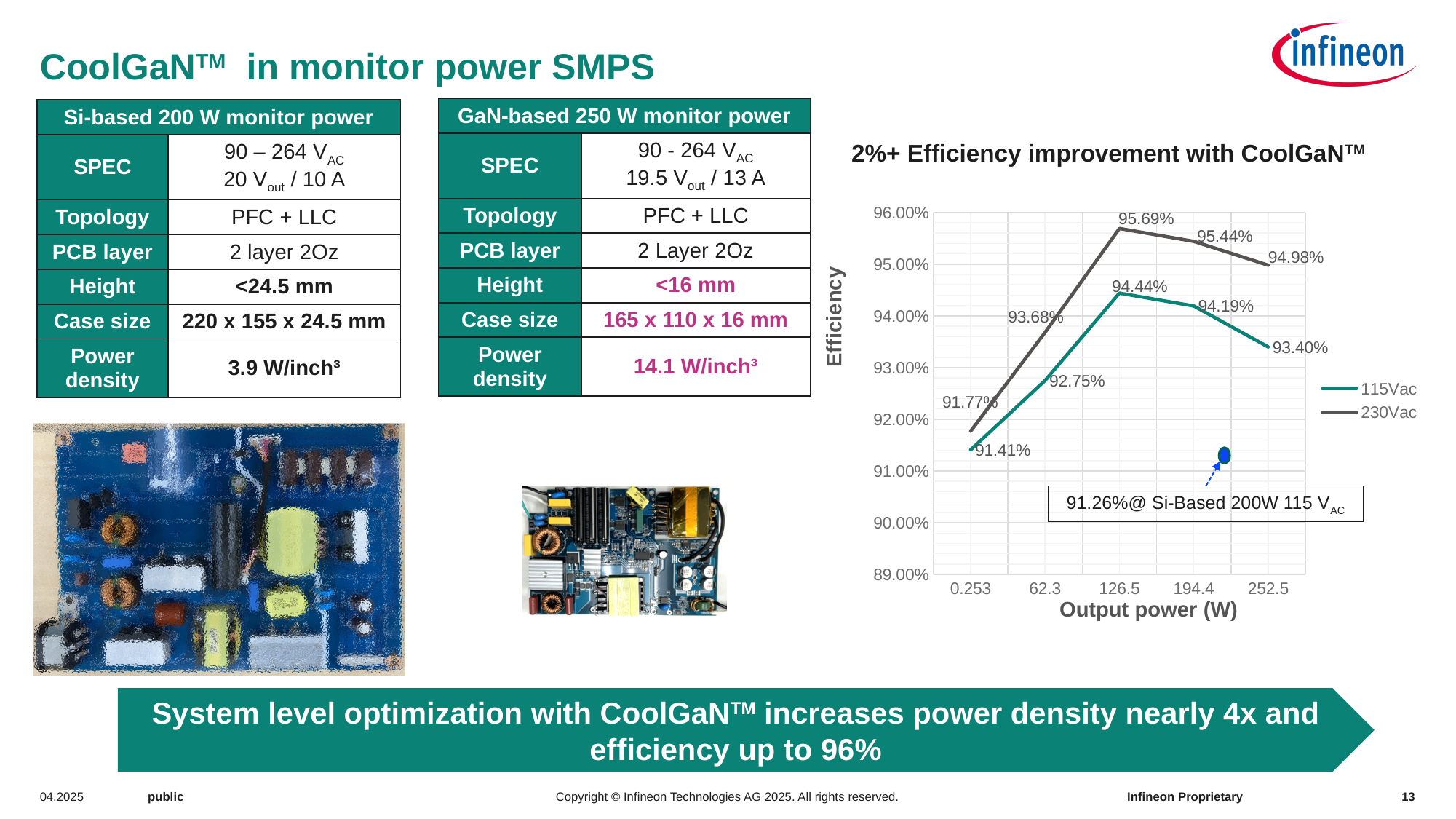
How many series does the chart legend list? 2 What is the difference between the 230Vac and 115Vac efficiencies at 126.5 W? 1.25% What is the efficiency of the 230Vac series at an output power of 126.5 W? 95.69% Does the 115Vac efficiency rise or fall between 126.5 W and 252.5 W? fall Which series has the higher efficiency at 194.4 W, 115Vac or 230Vac? 230Vac How many output power points are plotted on the x axis? 5 What is the efficiency of the 115Vac series at an output power of 252.5 W? 93.40% What type of chart is shown on the slide? line chart What is the efficiency of the 115Vac series at an output power of 0.253 W? 91.41% At which output power is the 115Vac series efficiency lowest? 0.253 What is the title of the chart? 2%+ Efficiency improvement with CoolGaN™ At which output power does the 230Vac series reach its highest efficiency? 126.5